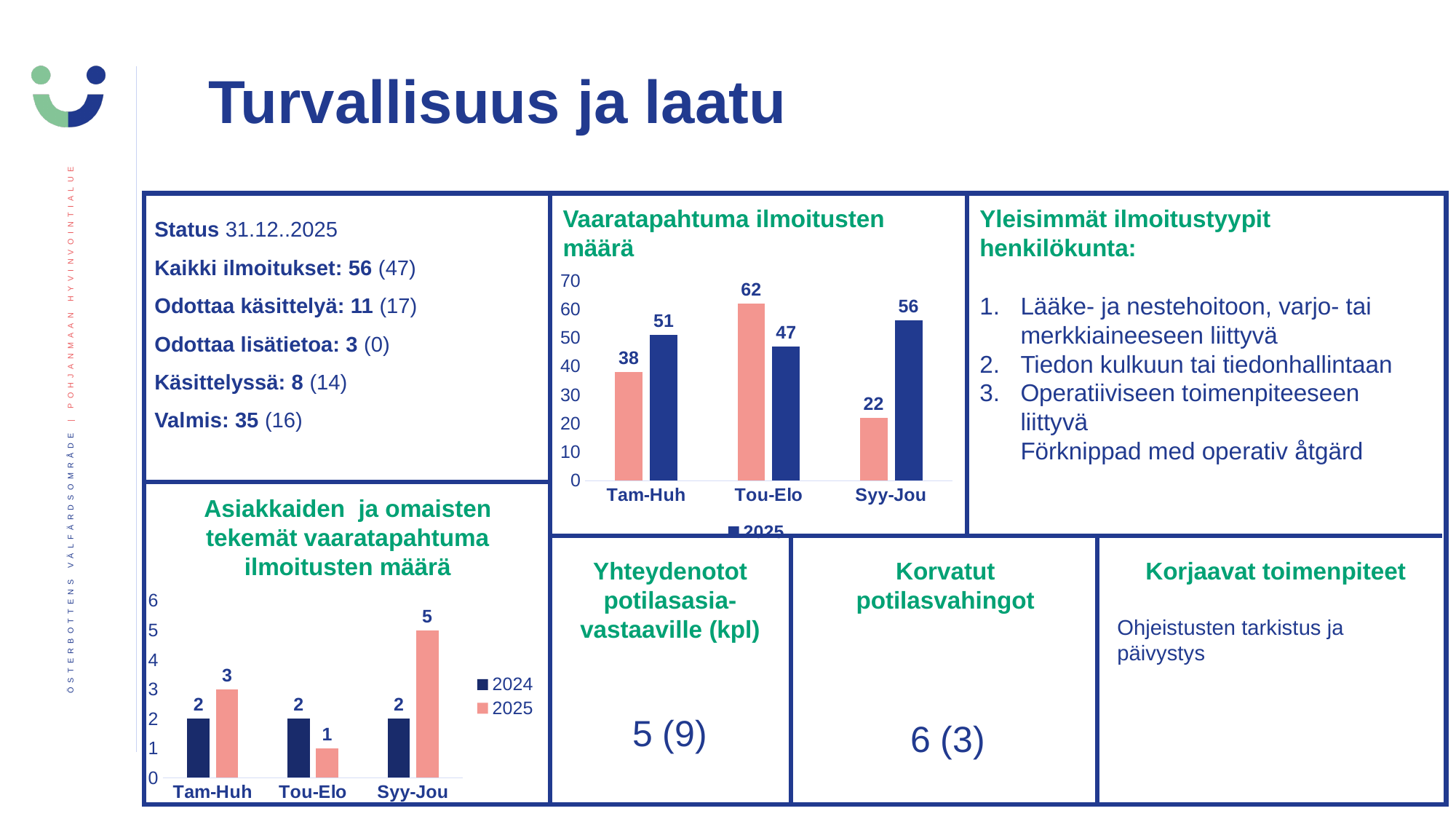
What type of chart is 'Vaaratapahtuma ilmoitusten määrä'? bar chart In the chart 'Vaaratapahtuma ilmoitusten määrä', what is the value of the dark blue bar for Syy-Jou? 56 In the chart 'Vaaratapahtuma ilmoitusten määrä', what is the value of the pink bar for Tou-Elo? 62 In the chart 'Vaaratapahtuma ilmoitusten määrä', which category has the lowest pink bar? Syy-Jou In the chart 'Asiakkaiden ja omaisten tekemät vaaratapahtuma ilmoitusten määrä', which category has the lowest 2025 value? Tou-Elo In the chart 'Vaaratapahtuma ilmoitusten määrä', what is the difference between the pink and dark blue bars for Tam-Huh? 13 In the chart 'Asiakkaiden ja omaisten tekemät vaaratapahtuma ilmoitusten määrä', what is the difference between the 2025 and 2024 values for Syy-Jou? 3 In the chart 'Vaaratapahtuma ilmoitusten määrä', how many categories are shown on the x axis? 3 In the chart 'Vaaratapahtuma ilmoitusten määrä', which is larger for Tou-Elo, the pink bar or the dark blue bar? the pink bar In the chart 'Asiakkaiden ja omaisten tekemät vaaratapahtuma ilmoitusten määrä', what is the 2025 value for Syy-Jou? 5 In the chart 'Asiakkaiden ja omaisten tekemät vaaratapahtuma ilmoitusten määrä', what is the 2024 value for Tou-Elo? 2 In the chart 'Asiakkaiden ja omaisten tekemät vaaratapahtuma ilmoitusten määrä', how many series does the legend list? 2